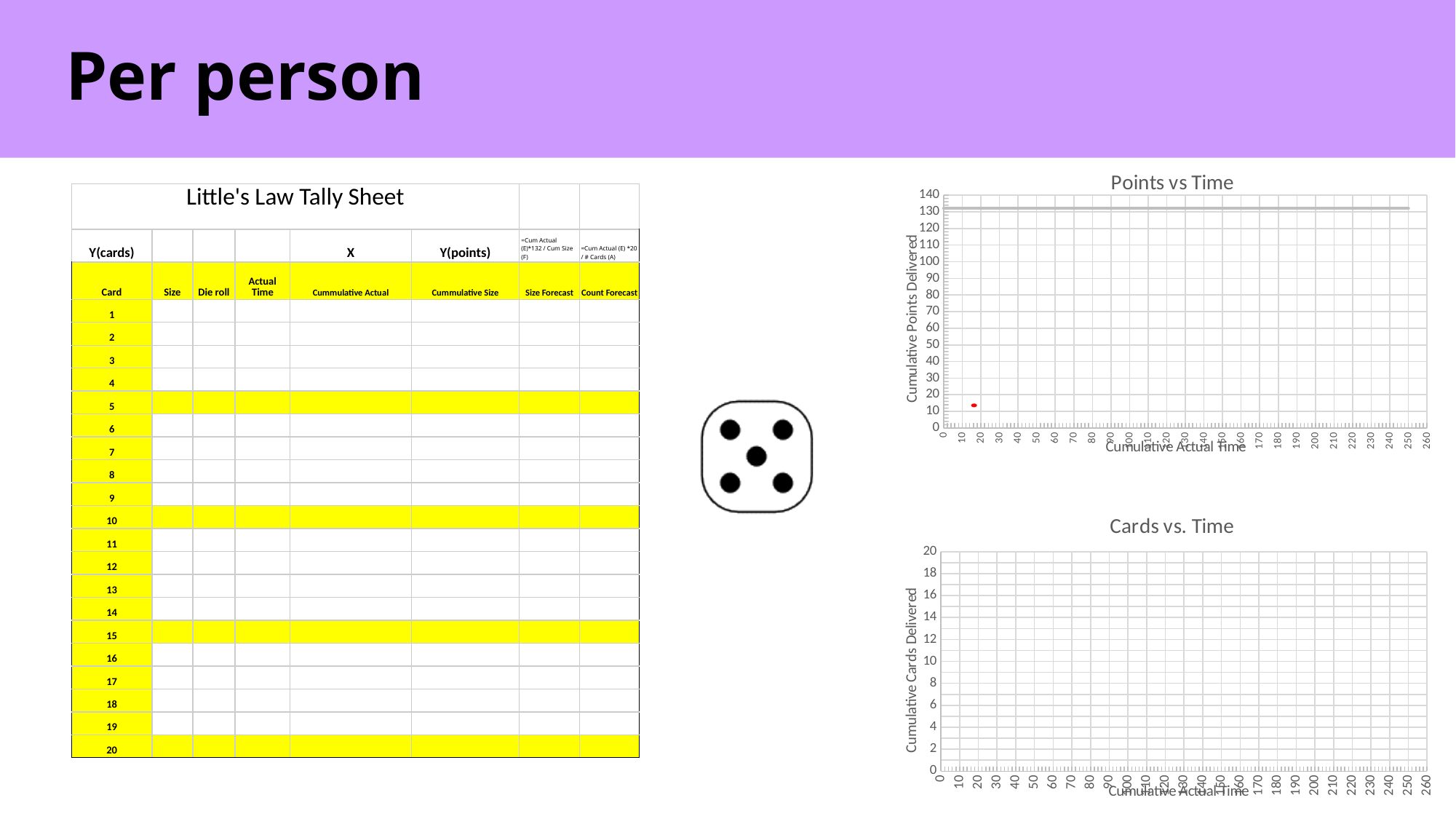
In the Points vs Time chart, how many red data points are plotted? 1 In the Cards vs. Time chart, how many data points are plotted? 0 In the Cards vs. Time chart, what is the label of the vertical axis? Cumulative Cards Delivered In the Points vs Time chart, is the horizontal gray line greater or less than 100 on the vertical axis? greater In the Points vs Time chart, what is the highest value shown on the vertical axis? 140 In the Points vs Time chart, what is the label of the vertical axis? Cumulative Points Delivered What kind of chart is the Points vs Time chart? scatter chart In the Points vs Time chart, is the vertical value of the red data point greater or less than 20? less